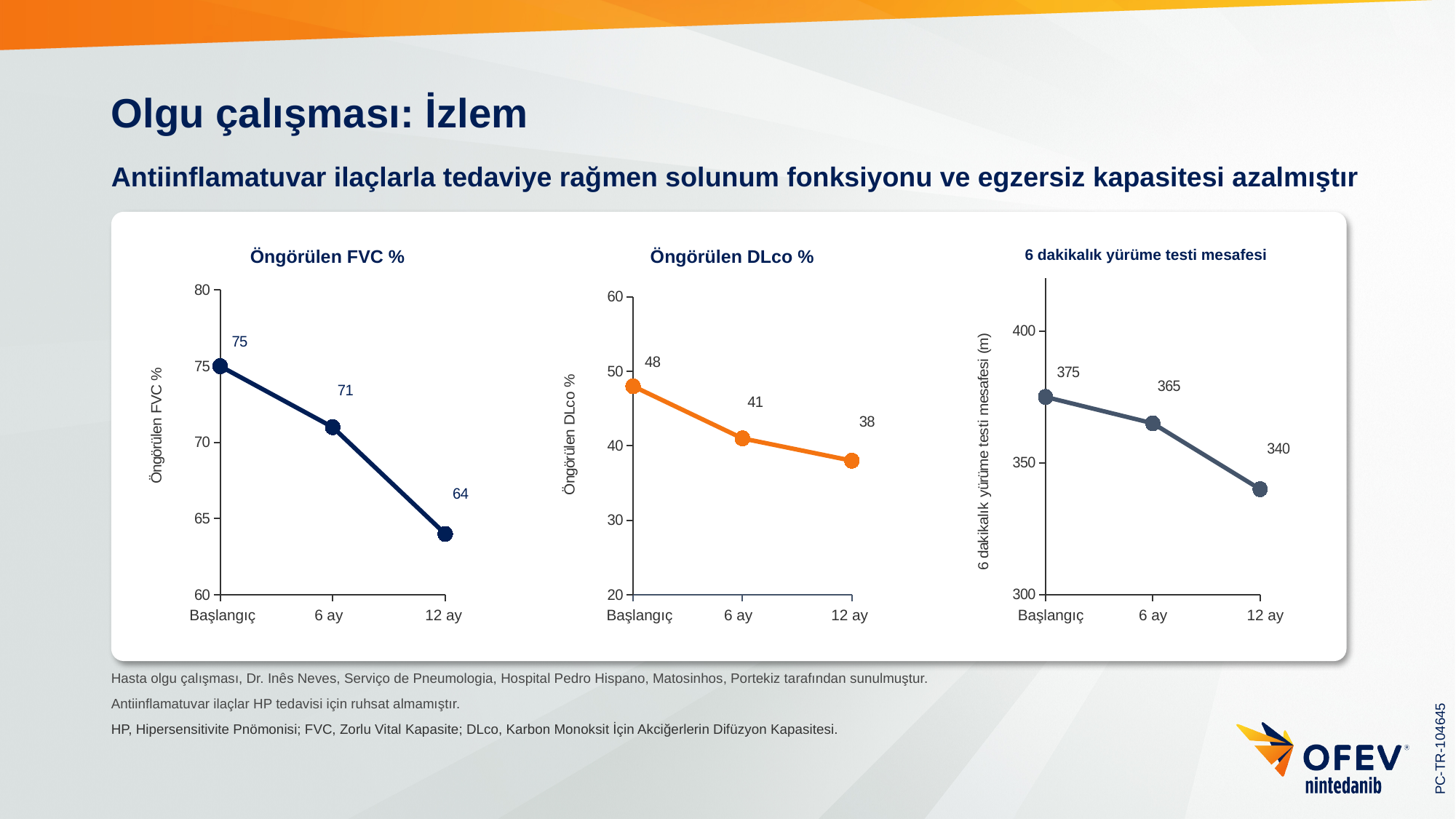
In the '6 dakikalık yürüme testi mesafesi' chart, which time point has the highest value? Başlangıç How many time points are plotted in the '6 dakikalık yürüme testi mesafesi' chart? 3 In the 'Öngörülen FVC %' chart, do the values rise or fall from Başlangıç to 12 ay? fall In the 'Öngörülen FVC %' chart, what is the difference between the Başlangıç value and the 12 ay value? 11 In the 'Öngörülen DLco %' chart, which time point has the lowest value? 12 ay In the '6 dakikalık yürüme testi mesafesi' chart, what is the difference between the 6 ay value and the 12 ay value? 25 In the 'Öngörülen DLco %' chart, what is the difference between the Başlangıç value and the 12 ay value? 10 In the '6 dakikalık yürüme testi mesafesi' chart, what is the value at 12 ay? 340 In the 'Öngörülen FVC %' chart, what is the value at Başlangıç? 75 In the 'Öngörülen DLco %' chart, what is the value at 6 ay? 41 What kind of chart is the 'Öngörülen DLco %' chart? line chart In the 'Öngörülen FVC %' chart, what is the value at 12 ay? 64